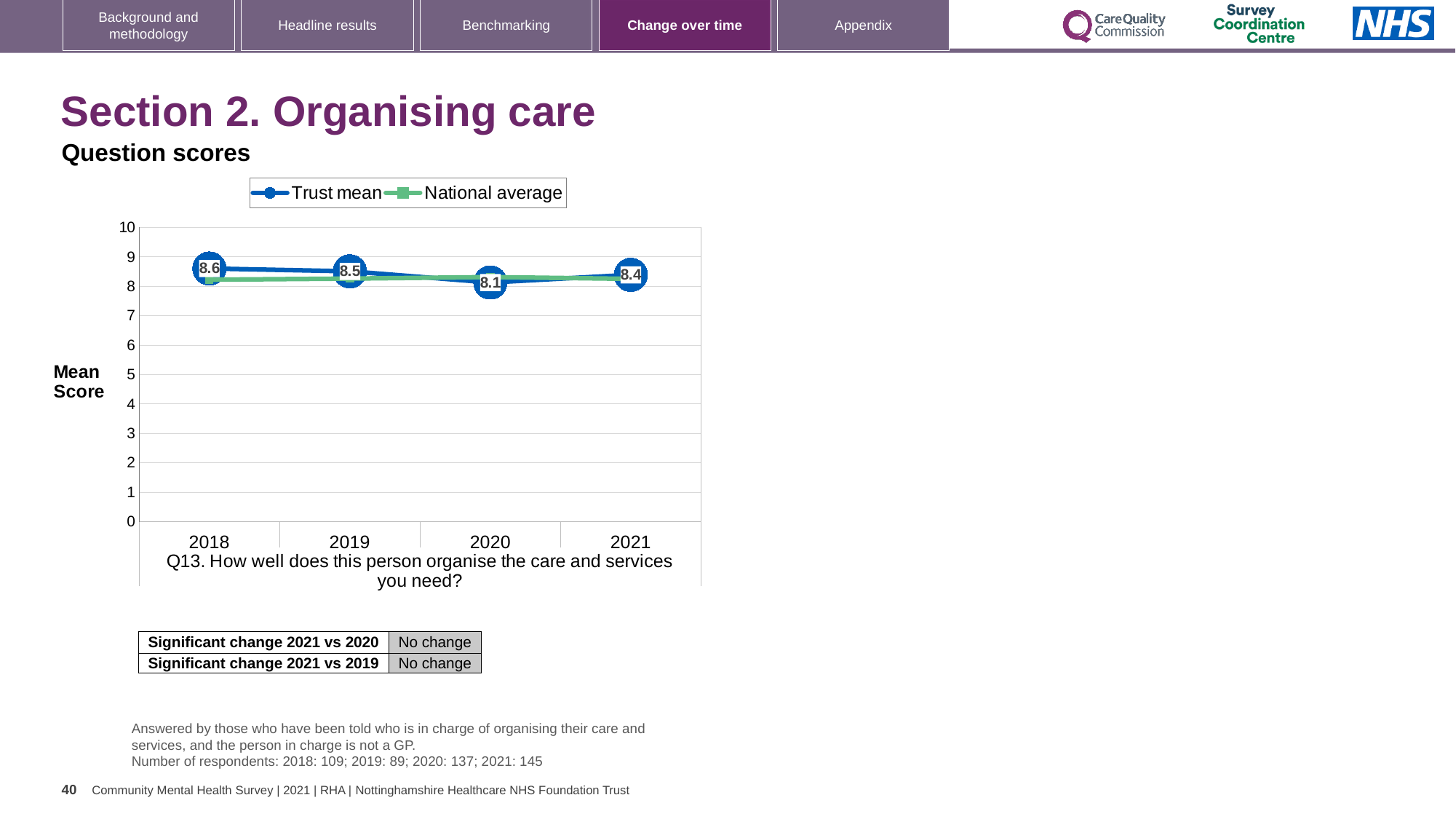
How many series does the legend list? 2 Is the National average value for 2018 greater or less than 5? greater In which year is the Trust mean highest? 2018 What is the Trust mean score for 2021? 8.4 Does the Trust mean rise or fall from 2018 to 2020? Fall Which is larger, the Trust mean for 2019 or for 2021? 2019 What is the Trust mean score for 2020? 8.1 What kind of chart is shown? Line chart In which year is the Trust mean lowest? 2020 What is the Trust mean score for 2018? 8.6 How many years are plotted on the x axis? 4 What is the difference between the Trust mean in 2018 and in 2020? 0.5